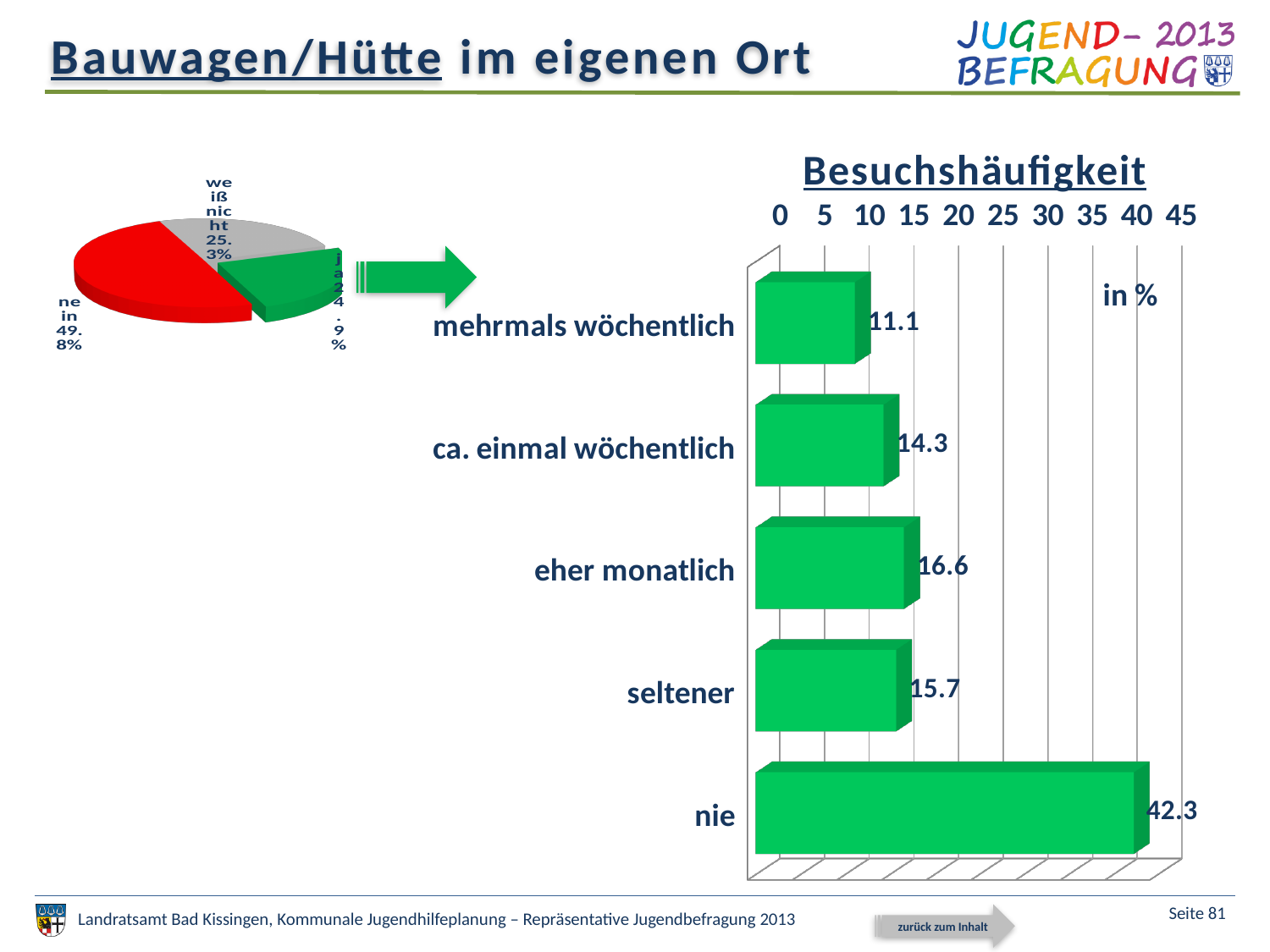
In the Besuchshäufigkeit bar chart, what is the value for "mehrmals wöchentlich"? 11.1 How many categories does the Besuchshäufigkeit bar chart show? 5 In the Besuchshäufigkeit bar chart, what is the value for "nie"? 42.3 In the pie chart on the left, what share does the "weiß nicht" slice have? 25.3% In the pie chart on the left, what share does the "nein" slice have? 49.8% In the Besuchshäufigkeit bar chart, which category has the lowest value? mehrmals wöchentlich In the Besuchshäufigkeit bar chart, what is the difference between the values for "nie" and "seltener"? 26.6 In the Besuchshäufigkeit bar chart, which is larger: the value for "ca. einmal wöchentlich" or the value for "seltener"? seltener In the Besuchshäufigkeit bar chart, what is the value for "eher monatlich"? 16.6 What unit is indicated in the Besuchshäufigkeit bar chart? in % What kind of chart is the Besuchshäufigkeit chart on the right? bar chart In the Besuchshäufigkeit bar chart, which category has the highest value? nie